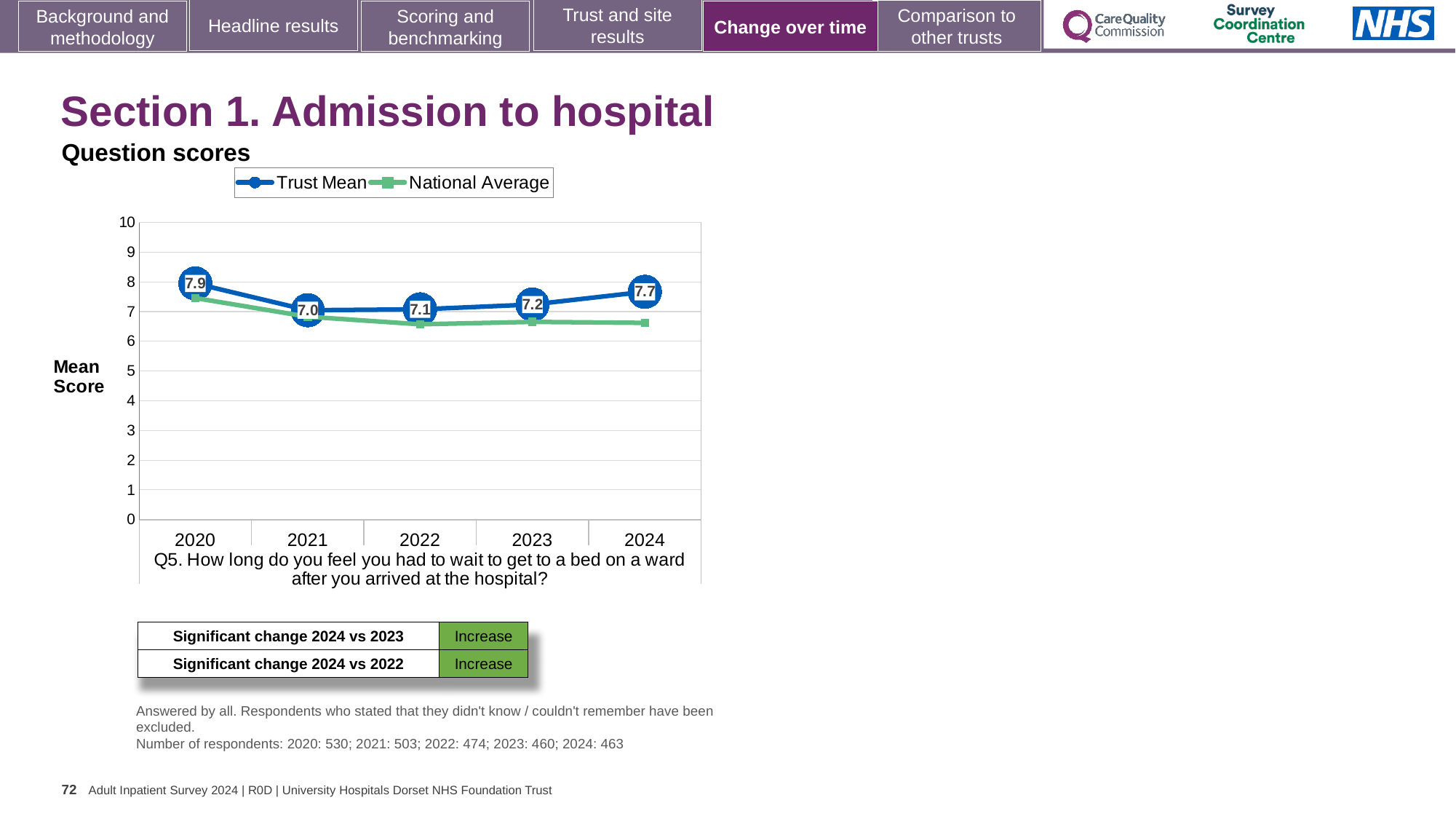
How many years are plotted on the x axis? 5 Which is larger, the Trust Mean score in 2020 or in 2024? 2020 What is the Trust Mean score for 2024? 7.7 Does the Trust Mean score rise or fall from 2021 to 2024? Rise What kind of chart is shown on the slide? Line chart What is the difference between the Trust Mean score in 2024 and in 2023? 0.5 In which year is the Trust Mean score lowest? 2021 What is the Trust Mean score for 2022? 7.1 In which year is the Trust Mean score highest? 2020 What is the Trust Mean score for 2020? 7.9 Is the National Average value for 2022 greater or less than 7? less How many series does the legend list? 2